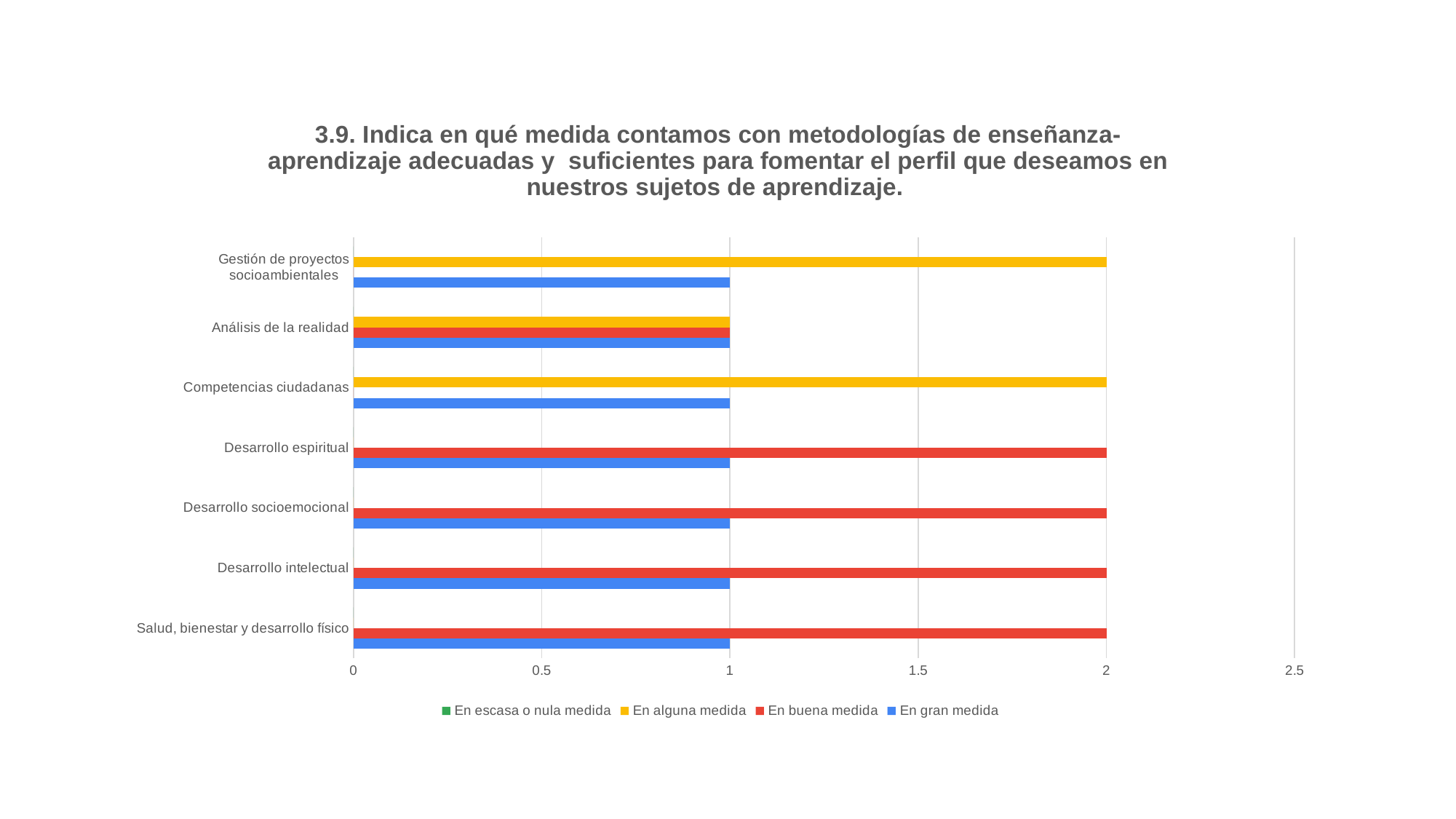
Is the value of 'En buena medida' for Desarrollo socioemocional greater or less than 1.5? greater What is the value of 'En buena medida' for Análisis de la realidad? 1 What is the difference between 'En buena medida' and 'En gran medida' for Desarrollo espiritual? 1 How many series does the legend list? 4 What is the value of 'En gran medida' for Desarrollo intelectual? 1 What is the highest value shown on the horizontal axis? 2.5 What is the value of 'En alguna medida' for Gestión de proyectos socioambientales? 2 What is the value of 'En buena medida' for Salud, bienestar y desarrollo físico? 2 What kind of chart is shown on the slide? Bar chart Which is larger for Competencias ciudadanas: 'En alguna medida' or 'En gran medida'? En alguna medida How many categories are listed on the vertical axis of the chart? 7 Which legend entry is shown in blue? En gran medida